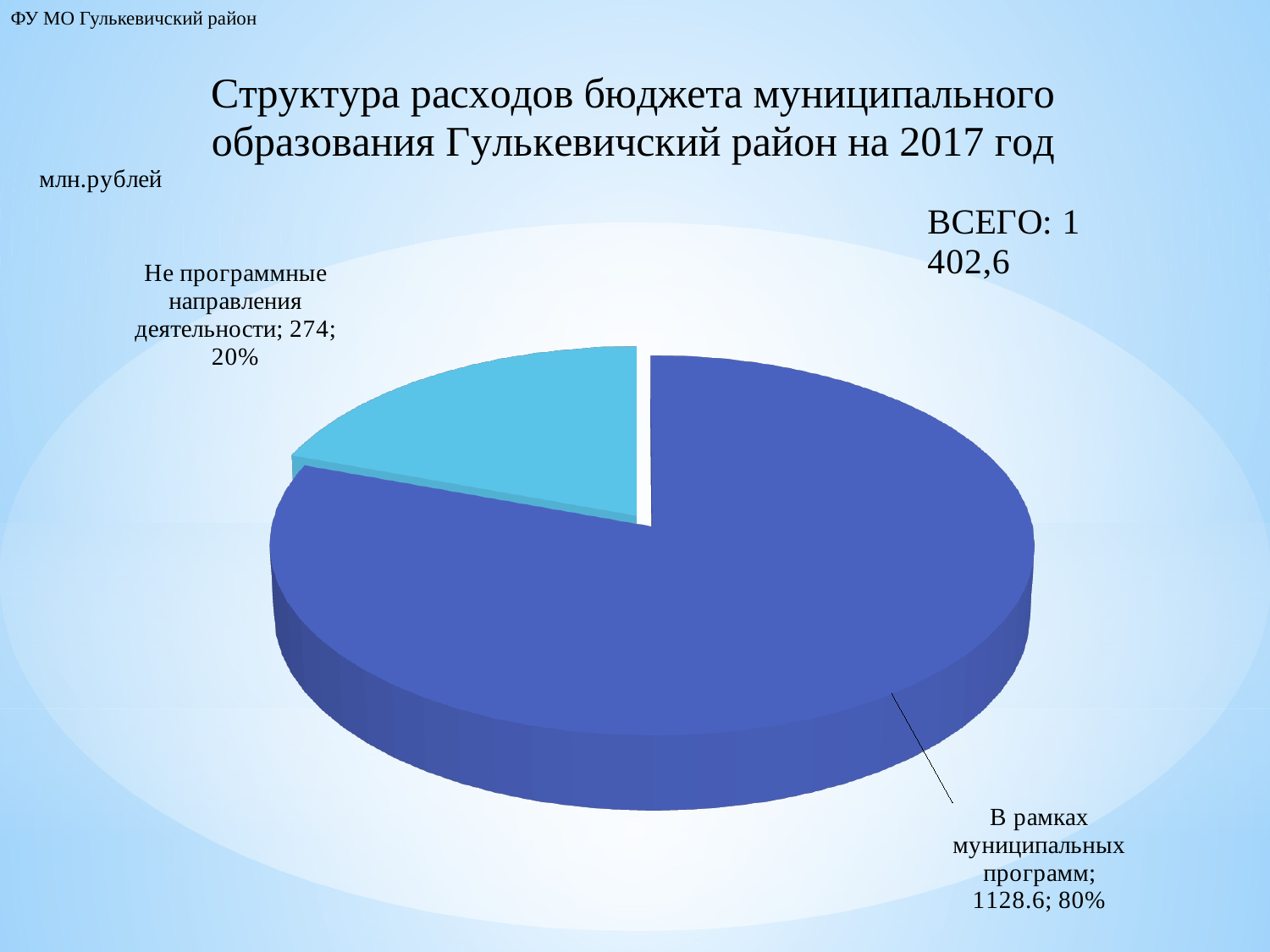
Which is larger: "В рамках муниципальных программ" or "Не программные направления деятельности"? В рамках муниципальных программ What colour is the slice for "Не программные направления деятельности"? light blue What total (ВСЕГО) is shown on the slide? 1 402,6 What is the value for "В рамках муниципальных программ"? 1128.6 How many slices does the pie chart have? 2 What is the value for "Не программные направления деятельности"? 274 What share of the pie does "В рамках муниципальных программ" take? 80% What share of the pie does "Не программные направления деятельности" take? 20% Which slice is the largest? В рамках муниципальных программ What kind of chart is shown on the slide? pie chart What unit of measurement is stated on the slide? млн.рублей Which slice is the smallest? Не программные направления деятельности